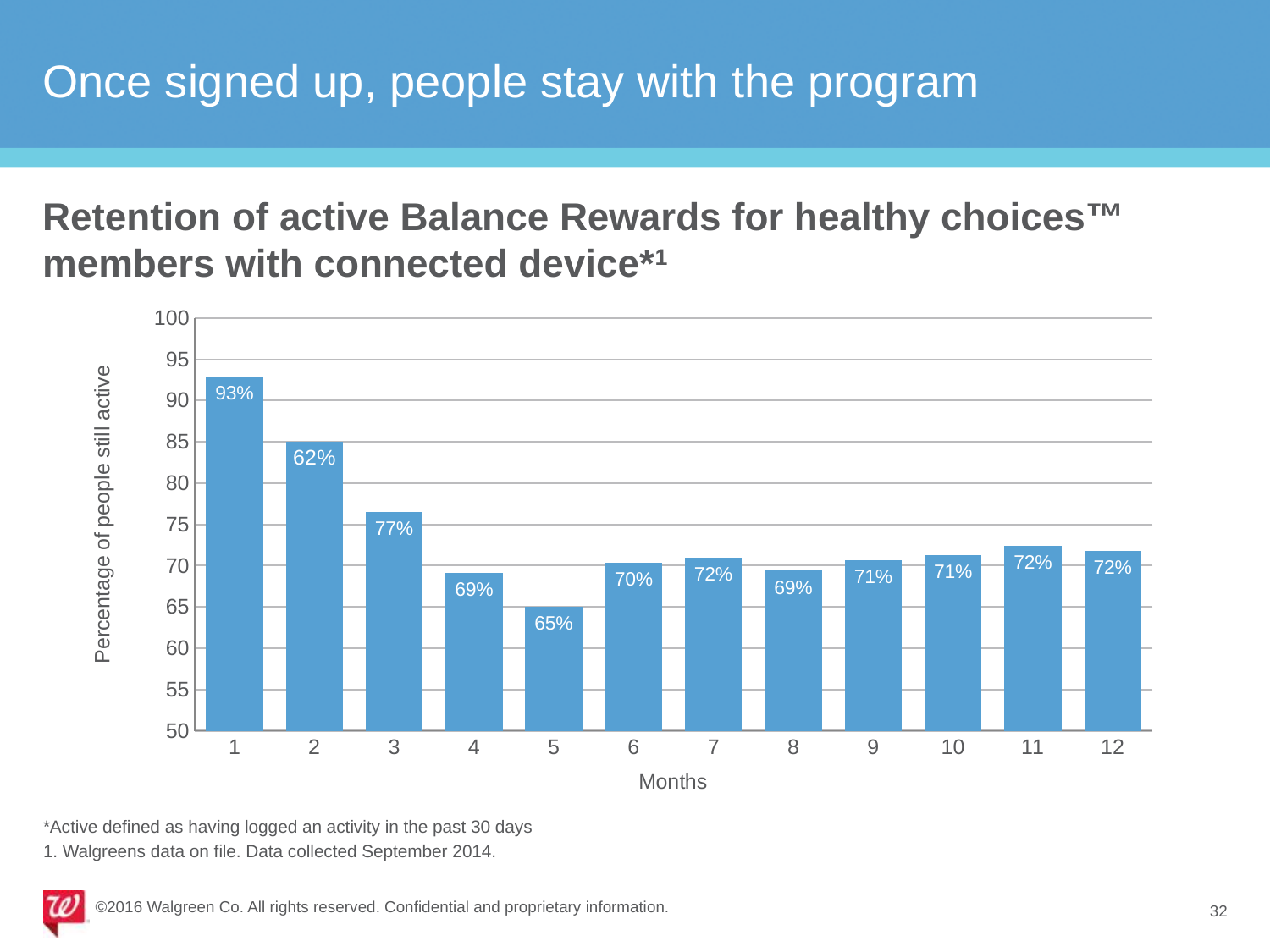
Which month has the highest percentage of people still active? 1 What is the percentage of people still active at month 5? 65% How many months are shown on the x axis? 12 What type of chart is shown on the slide? bar chart What is the difference in percentage points between month 1 and month 12? 21 What is the title of the y axis? Percentage of people still active Does the value rise or fall from month 1 to month 2? fall What is the percentage of people still active at month 3? 77% Which is larger, the value for month 3 or the value for month 5? month 3 Is the value for month 1 greater or less than 90? greater What is the percentage of people still active at month 1? 93% What is the percentage of people still active at month 12? 72%